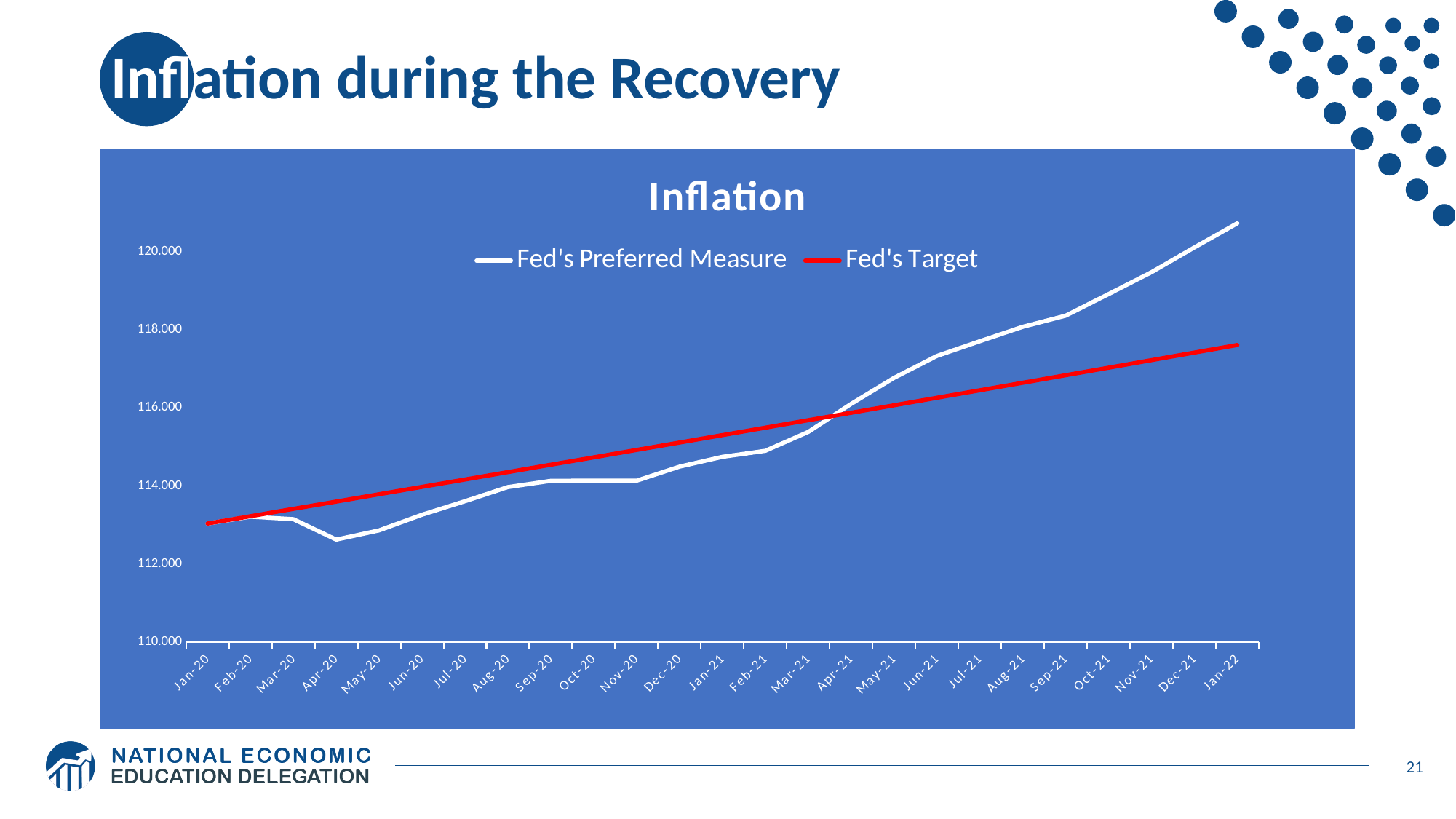
How many series does the legend of the Inflation chart list? 2 In which month does the Fed's Preferred Measure line reach its lowest point? Apr-20 Is the value of Fed's Target at Jan-22 greater or less than 118.000? less Is the value of Fed's Preferred Measure at Jan-22 greater or less than 120.000? greater Does the Fed's Target line rise or fall from Jan-20 to Jan-22? Rises Overall, does the Fed's Preferred Measure line rise or fall from Jan-20 to Jan-22? Rises How many monthly points are plotted along the x axis of the Inflation chart? 25 What colour is the Fed's Target line in the chart? Red What kind of chart is shown on the slide? Line chart Is the value of Fed's Preferred Measure at Apr-20 greater or less than 114.000? less At Oct-20, which series is higher: Fed's Preferred Measure or Fed's Target? Fed's Target At Jan-22, which series is higher: Fed's Preferred Measure or Fed's Target? Fed's Preferred Measure